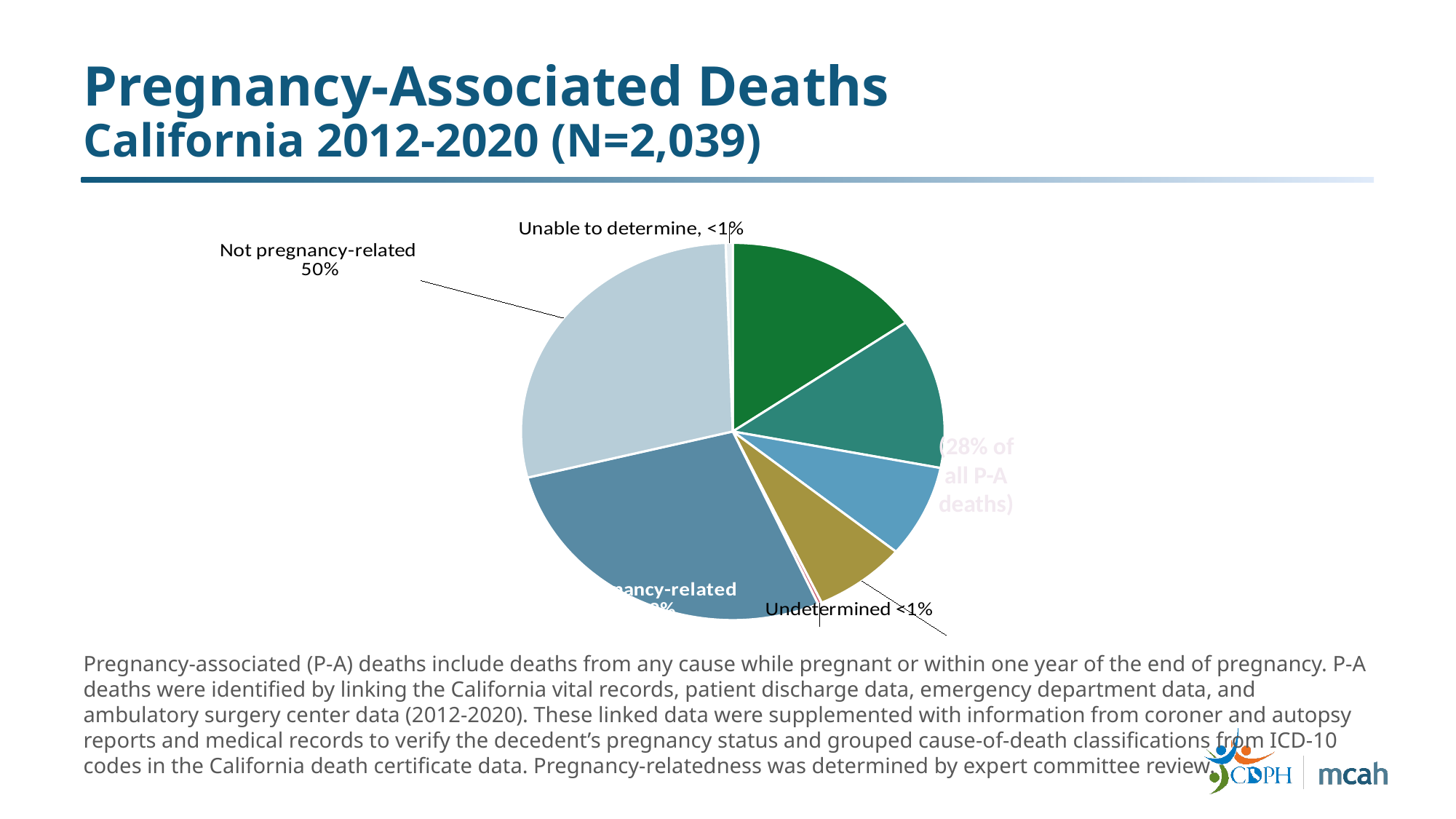
Which is larger, the Not pregnancy-related slice or the Undetermined slice? Not pregnancy-related What is the total number of pregnancy-associated deaths (N) given in the slide title? 2,039 Which years does the chart cover according to the title? 2012-2020 What kind of chart is shown on the slide? pie chart What share of the pie is labelled Undetermined? <1% What share of the pie is labelled Unable to determine? <1% Which labelled category has the largest slice of the pie? Not pregnancy-related What share of pregnancy-associated deaths is labelled as Not pregnancy-related? 50%